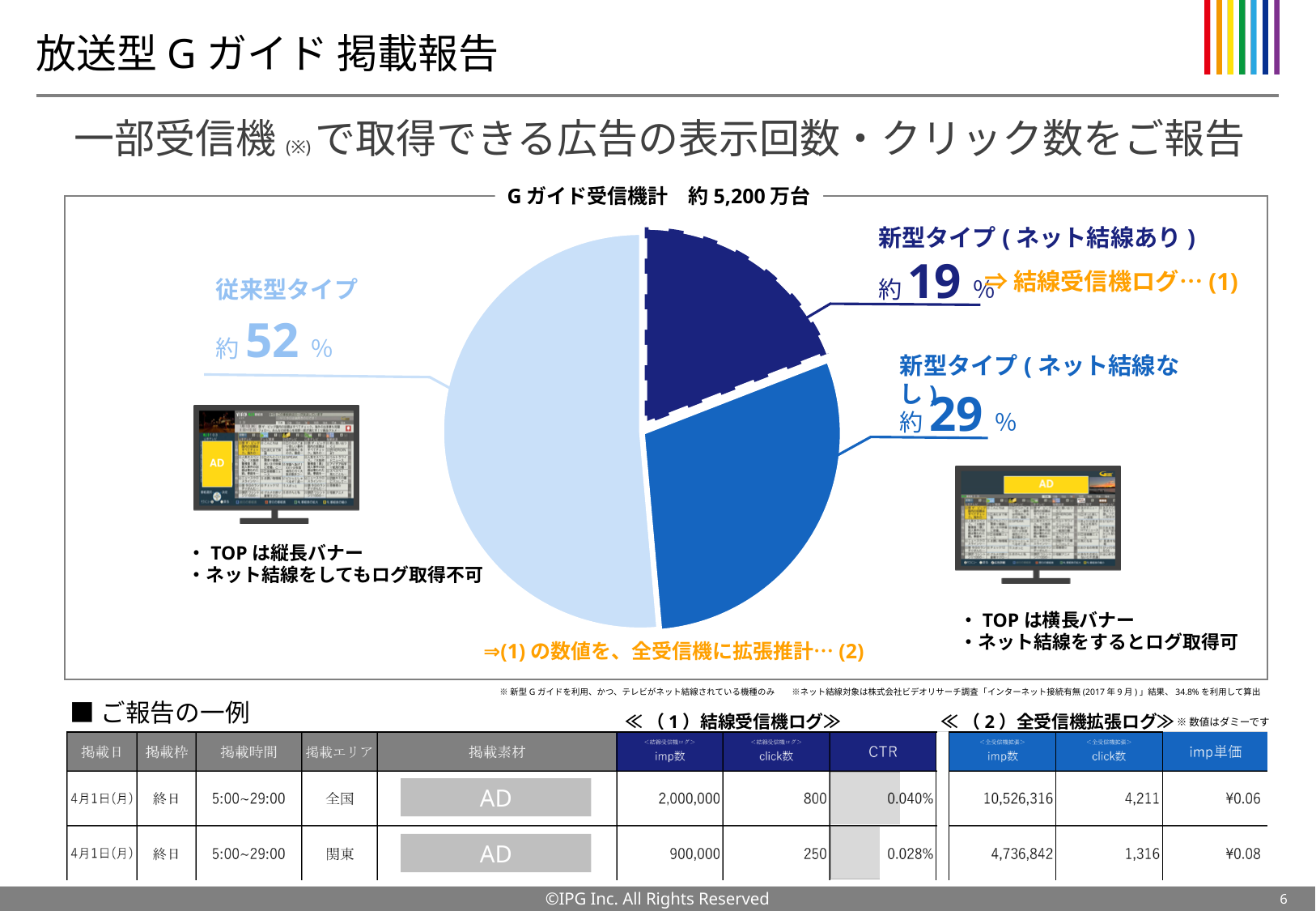
What share of the pie chart is labelled for 従来型タイプ? 約52% Which slice of the pie chart is the largest? 従来型タイプ What is the total number of G ガイド receivers stated above the pie chart? 約5,200万台 What kind of chart is shown on the slide? pie chart What share of the pie chart is labelled for 新型タイプ(ネット結線なし)? 約29% How many slices does the pie chart have? 3 Which slice of the pie chart is the smallest? 新型タイプ(ネット結線あり) What share of the pie chart is labelled for 新型タイプ(ネット結線あり)? 約19% Is the share for 従来型タイプ in the pie chart greater or less than 50%? greater Which is larger in the pie chart: 新型タイプ(ネット結線あり) or 新型タイプ(ネット結線なし)? 新型タイプ(ネット結線なし) By how many percentage points does 従来型タイプ exceed 新型タイプ(ネット結線なし) in the pie chart? 23 Which slice of the pie chart is drawn with a dashed outline? 新型タイプ(ネット結線あり)